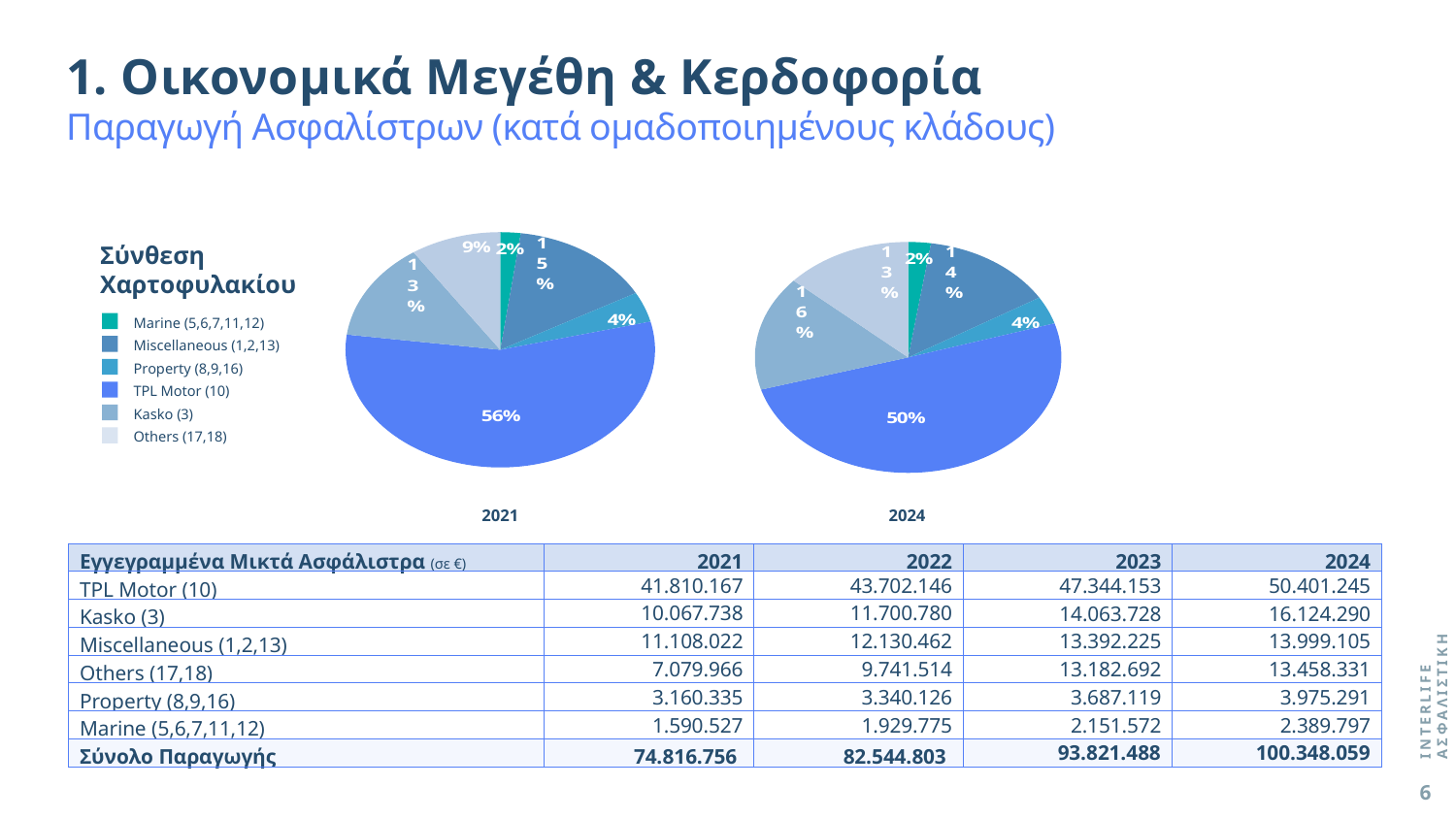
In the 2024 pie chart, what share does Kasko (3) have? 16% In the 2024 pie chart, what share does TPL Motor (10) have? 50% By how many percentage points did the TPL Motor (10) share fall from the 2021 pie chart to the 2024 pie chart? 6 percentage points In the 2021 pie chart, what share does Others (17,18) have? 9% In the 2021 pie chart, what share does Miscellaneous (1,2,13) have? 15% What is the title given to the pie charts' legend block? Σύνθεση Χαρτοφυλακίου What type of charts are shown on the slide? Pie charts In the 2021 pie chart, what share does TPL Motor (10) have? 56% In the 2024 pie chart, which is larger: the share of Kasko (3) or the share of Others (17,18)? Kasko (3) In the 2021 pie chart, which category has the smallest share? Marine (5,6,7,11,12) In the 2024 pie chart, which category has the largest share? TPL Motor (10) How many categories does the legend list for the pie charts? 6